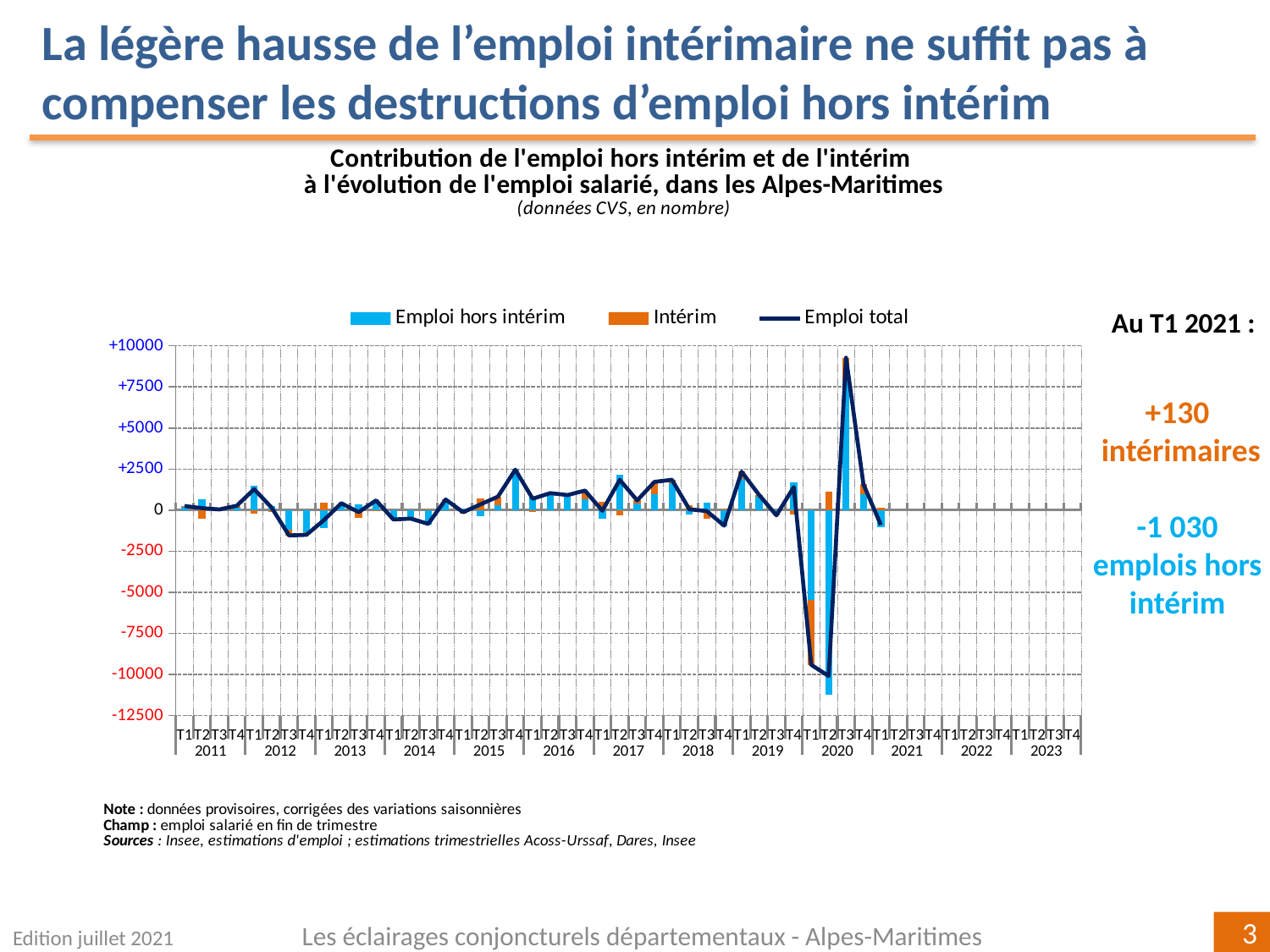
Does the Emploi total line rise or fall from T2 2020 to T3 2020? rise According to the slide, what is the value for Emploi hors intérim at T1 2021? -1 030 Is the value for Emploi total at T1 2020 greater or less than -7500? less Is the value for Emploi total at T3 2020 greater or less than +7500? greater How many series does the chart legend list? 3 Which colour represents the Intérim series in the chart? Orange What kind of chart is shown on the slide? A bar chart combined with a line chart Is the value for Emploi hors intérim at T2 2020 greater or less than -10000? less Which is larger, the Emploi total value at T3 2020 or at T1 2020? T3 2020 In which quarter is the Emploi hors intérim bar the highest? T3 2020 According to the slide, what is the value for Intérim at T1 2021? +130 In which quarter is the Emploi hors intérim bar the lowest? T2 2020